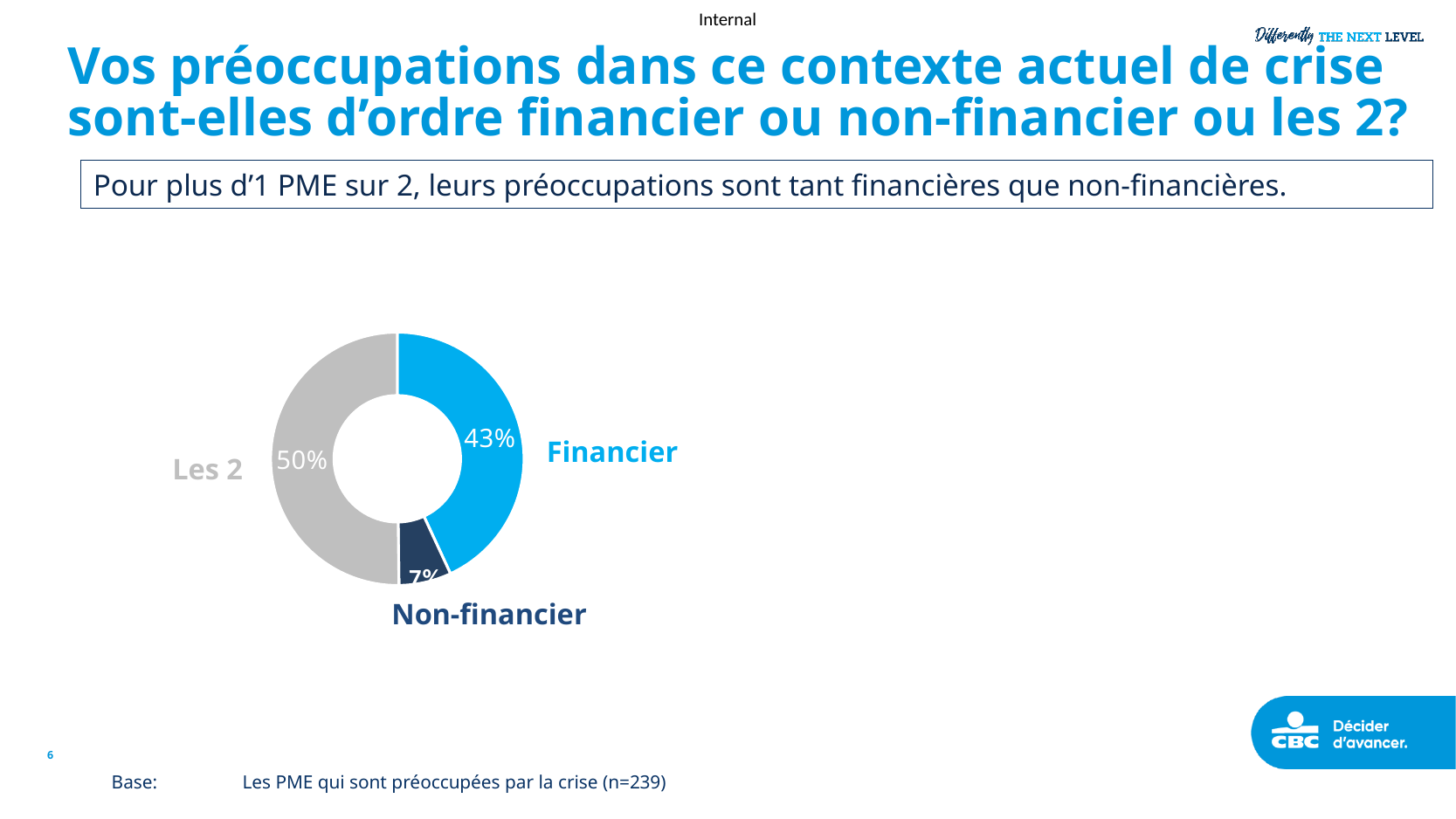
What is the sample size (n) given in the base note at the bottom of the slide? 239 What percentage of the donut chart is labelled "Les 2"? 50% What is the difference in percentage points between "Financier" and "Non-financier"? 36 Which category has the smallest share of the donut chart? Non-financier What colour is the "Les 2" slice of the donut chart? Grey Which category has the largest share of the donut chart? Les 2 What percentage of the donut chart is labelled "Financier"? 43% What kind of chart is shown on the slide? Donut (pie) chart What is the difference in percentage points between "Les 2" and "Financier"? 7 What percentage of the donut chart is labelled "Non-financier"? 7% Which is larger, the share for "Financier" or the share for "Non-financier"? Financier How many categories are shown in the donut chart? 3